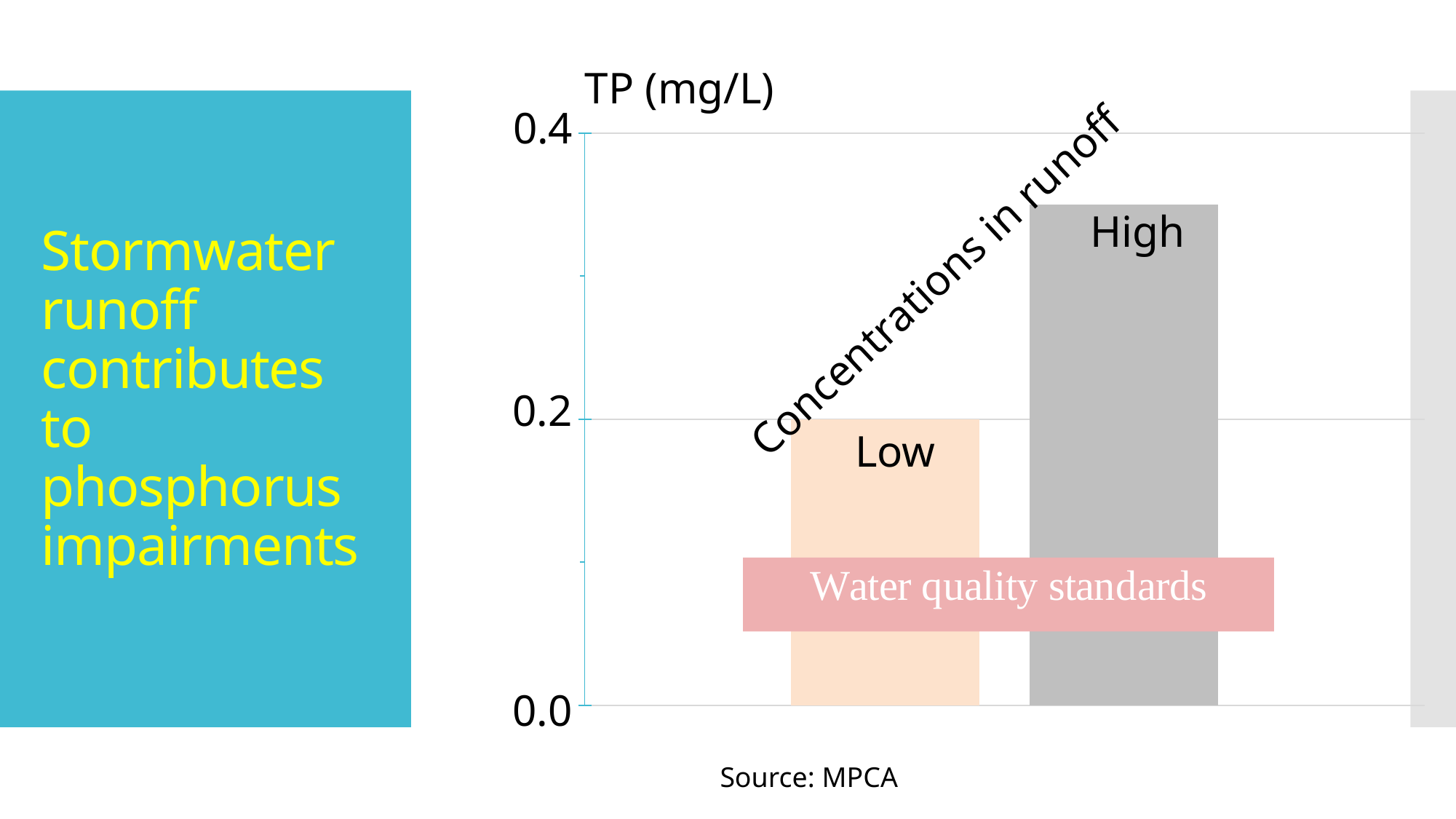
Which bar is the highest in the chart? High Is the value for the High bar greater or less than 0.2? greater What does the pink band across the bars represent? Water quality standards What is the label of the vertical axis? TP (mg/L) Which bar is taller, Low or High? High What is the TP value (mg/L) for the Low bar? 0.2 Is the value for the High bar greater or less than 0.4? less How many bars are plotted in the chart? 2 Which bar is the lowest in the chart? Low What kind of chart is shown on the slide? bar chart